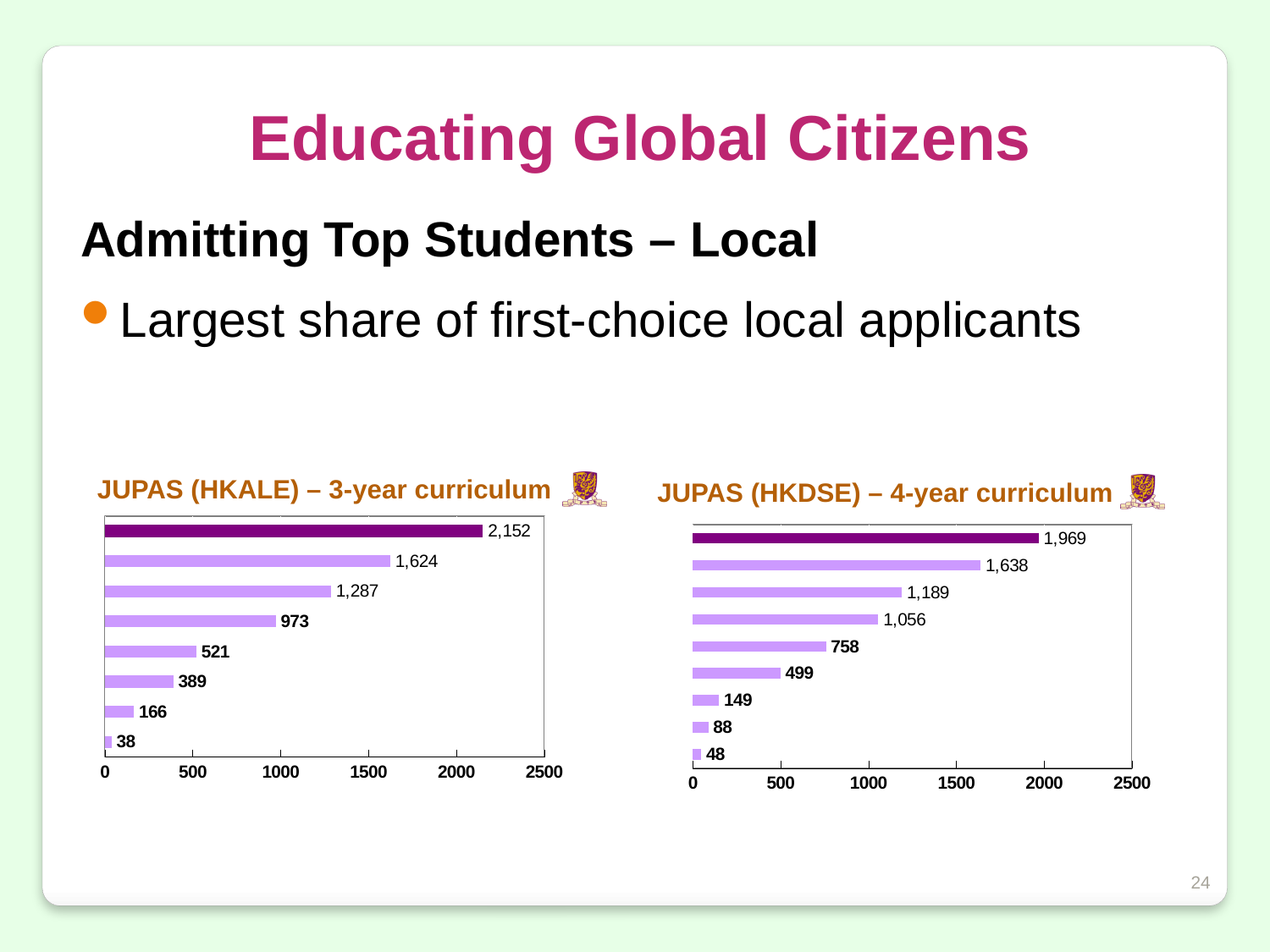
How many bars are plotted in the JUPAS (HKALE) – 3-year curriculum chart? 8 In the JUPAS (HKDSE) – 4-year curriculum chart, what is the value of the longest bar? 1,969 In the JUPAS (HKALE) – 3-year curriculum chart, what is the value of the shortest bar? 38 In the JUPAS (HKALE) – 3-year curriculum chart, what is the difference between the top bar and the second bar? 528 What kind of chart is the JUPAS (HKDSE) – 4-year curriculum chart? Bar chart What is the maximum value shown on the x axis of the JUPAS (HKALE) – 3-year curriculum chart? 2500 In the JUPAS (HKDSE) – 4-year curriculum chart, what is the value of the fourth bar from the top? 1,056 In the JUPAS (HKALE) – 3-year curriculum chart, what is the value of the longest bar? 2,152 Which chart has the larger top value, JUPAS (HKALE) – 3-year curriculum or JUPAS (HKDSE) – 4-year curriculum? JUPAS (HKALE) – 3-year curriculum In the JUPAS (HKDSE) – 4-year curriculum chart, what is the value of the shortest bar? 48 In the JUPAS (HKDSE) – 4-year curriculum chart, what is the difference between the top bar and the second bar? 331 How many bars are plotted in the JUPAS (HKDSE) – 4-year curriculum chart? 9